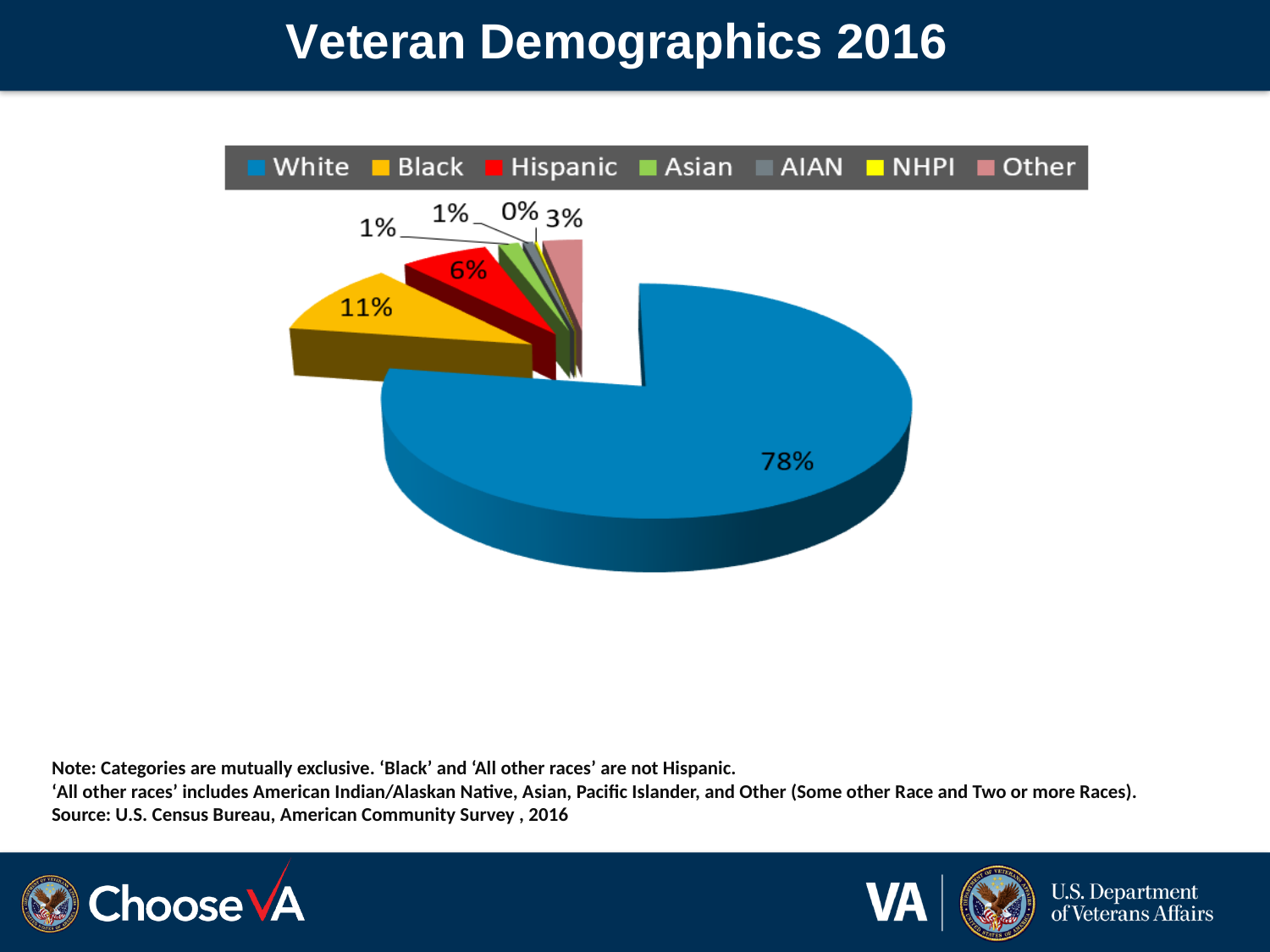
What share of veterans is White according to the pie chart? 78% What percentage does the Hispanic slice show? 6% How many categories does the legend list? 7 What percentage is shown for NHPI? 0% Which category has the largest share of the pie? White What kind of chart is shown on the slide? Pie chart Which is larger, the Black slice or the Hispanic slice? Black What colour is the White slice in the pie chart? Blue Which category has the smallest share of the pie? NHPI What percentage does the Black slice show? 11% What percentage is shown for the Other category? 3% What is the difference in percentage points between the White and Black slices? 67